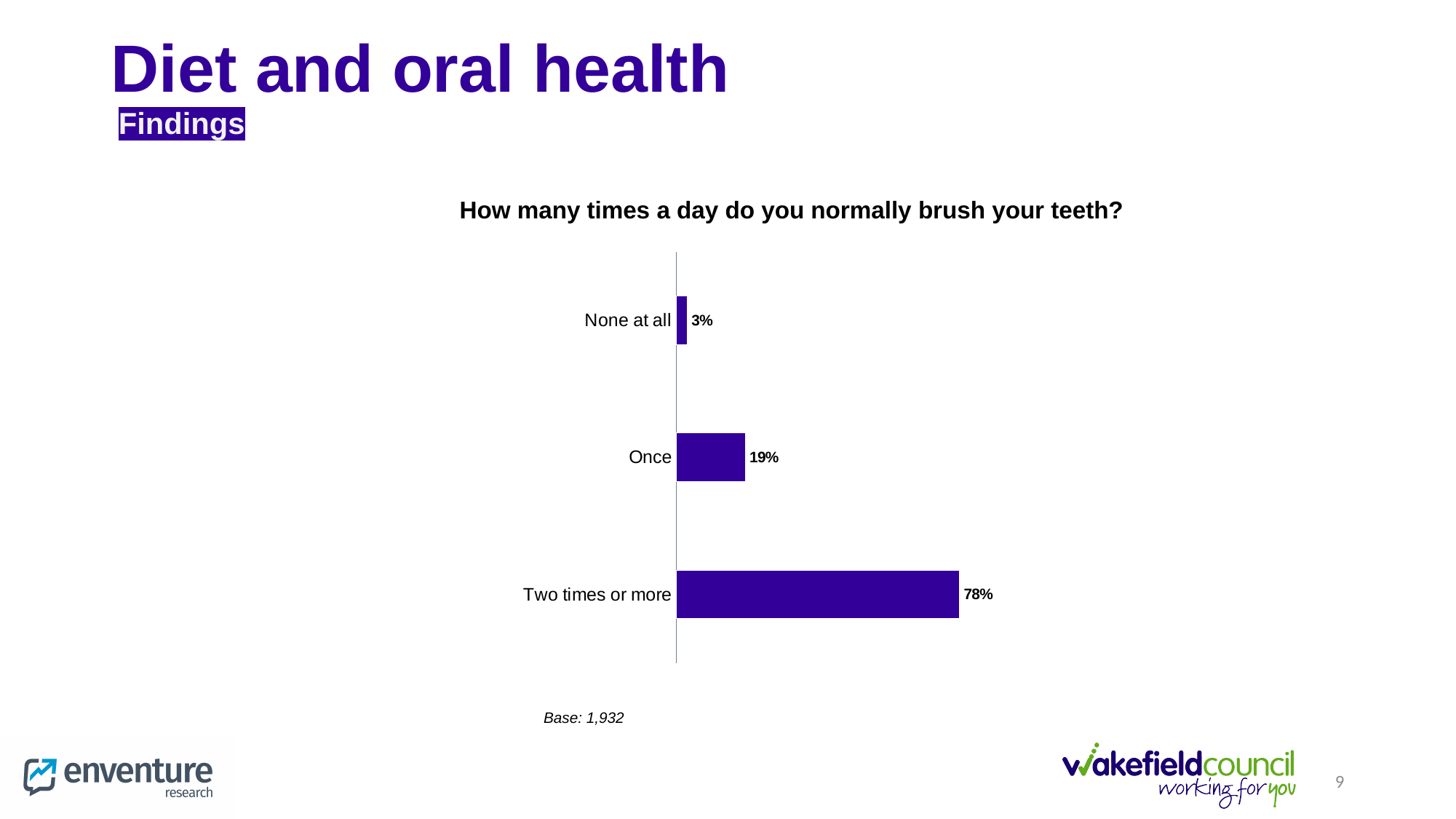
What percentage of respondents said they brush their teeth two times or more a day? 78% What type of chart is shown on the slide? Bar chart What is the difference in percentage points between 'Once' and 'None at all'? 16 What is the difference in percentage points between 'Two times or more' and 'Once'? 59 What percentage of respondents said they brush their teeth once a day? 19% Which is larger, the percentage for 'Once' or for 'None at all'? Once How many response categories are shown in the chart? 3 Which response category has the lowest percentage? None at all What is the title of the chart? How many times a day do you normally brush your teeth? What percentage of respondents said they do not brush their teeth at all? 3% What is the base (number of respondents) stated below the chart? 1,932 Which response category has the highest percentage? Two times or more